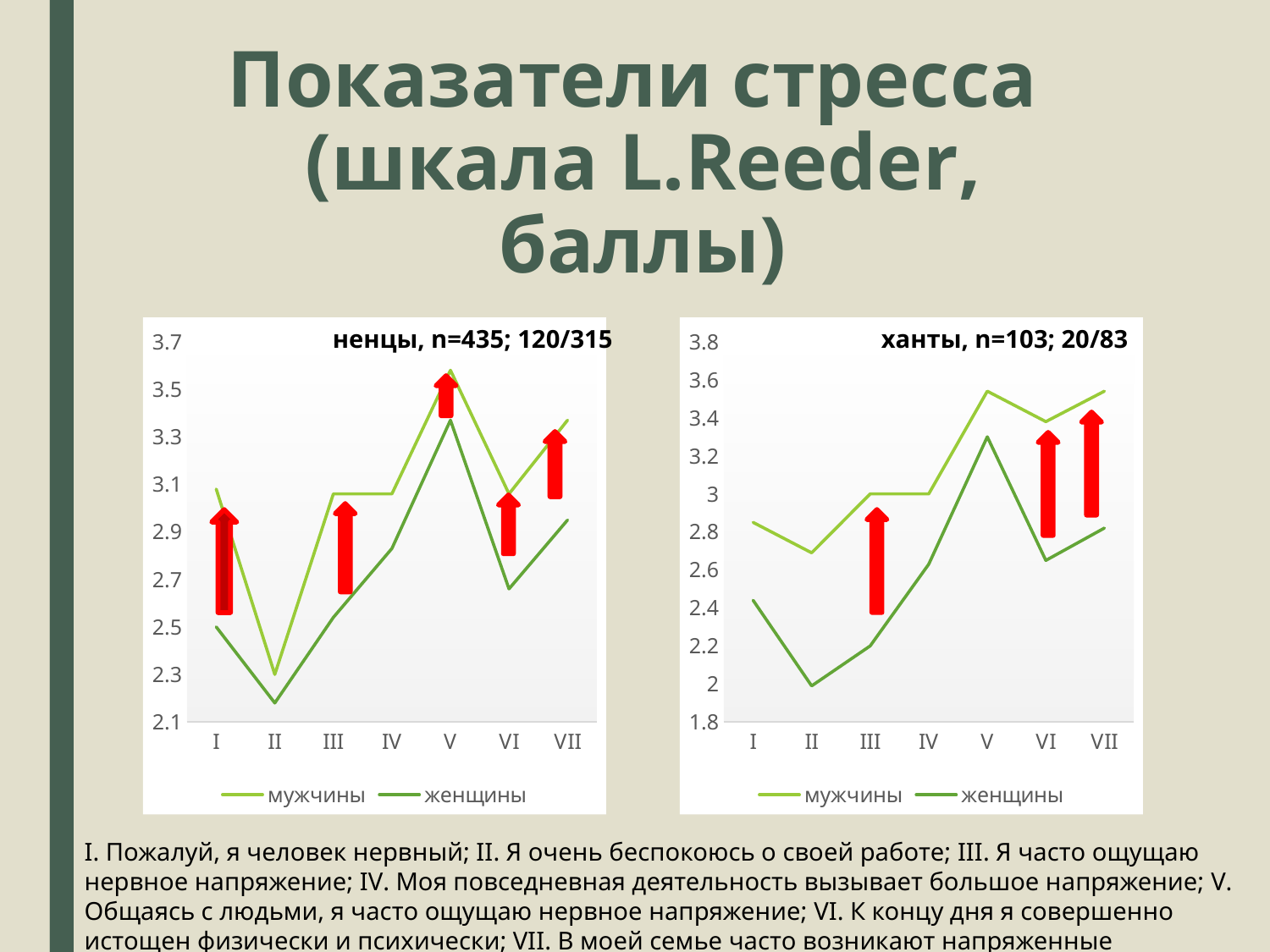
What kind of chart is the left chart titled "ненцы, n=435; 120/315"? line chart In the right chart (ханты), does the женщины line rise or fall from category II to category V? rise How many series does the legend of the left chart (ненцы) list? 2 In the left chart (ненцы), at which category does the мужчины line reach its highest value? V What are the two legend entries of the right chart (ханты)? мужчины, женщины In the right chart (ханты), at which category does the женщины line reach its highest value? V In the left chart (ненцы), is the value for женщины at category II greater or less than 2.3? less How many categories are shown on the x axis of the right chart titled "ханты, n=103; 20/83"? 7 In the left chart (ненцы), at which category does the женщины line reach its lowest value? II In the right chart (ханты), at which category does the женщины line reach its lowest value? II In the right chart (ханты), which series has the higher value at category III, мужчины or женщины? мужчины In the right chart (ханты), is the value for мужчины at category V greater or less than 3.4? greater